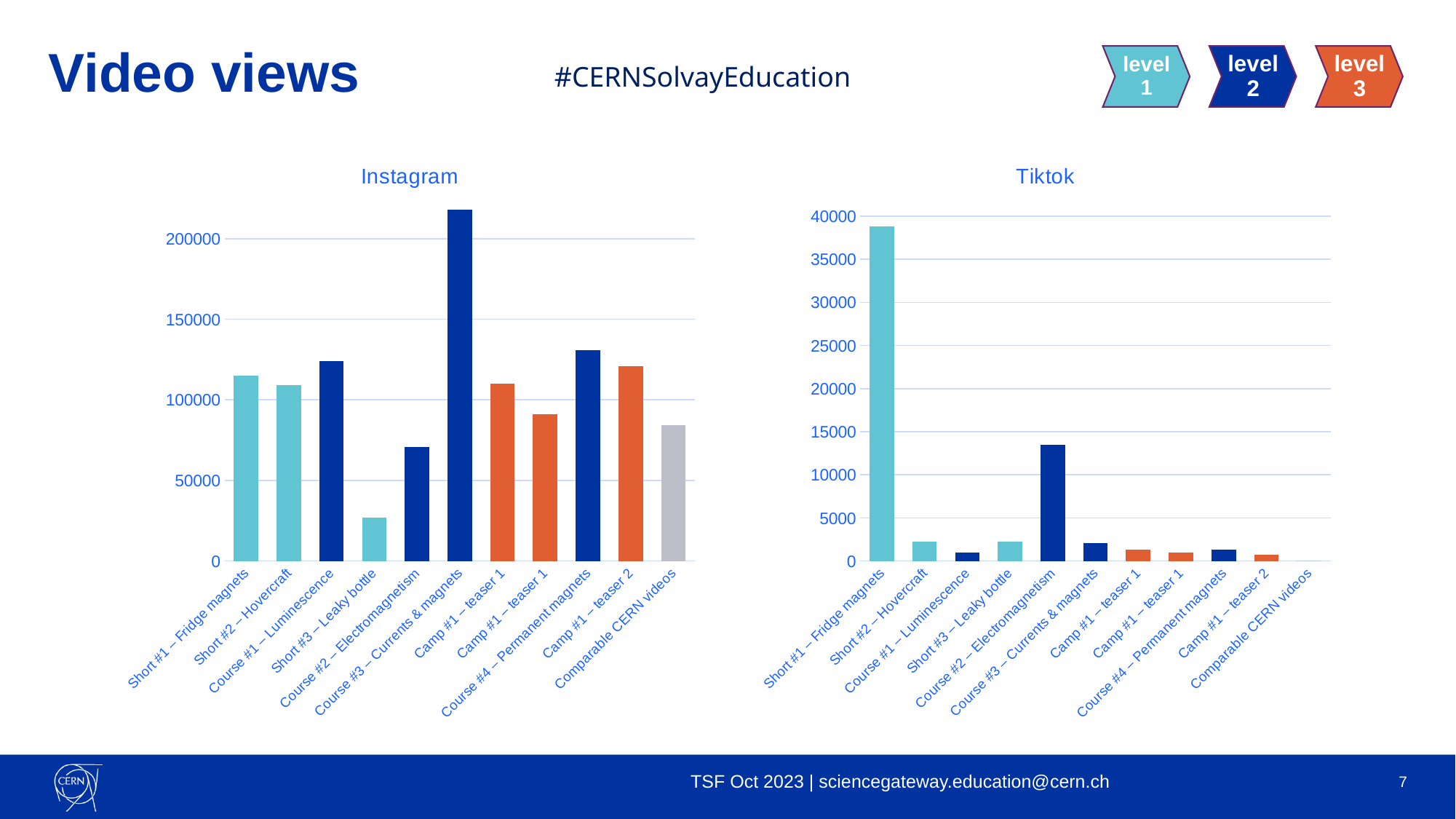
In the Instagram chart, is the value for Course #3 – Currents & magnets greater or less than 200000? greater What kind of chart is the Instagram chart? bar chart What are the titles of the two charts on the slide? Instagram and Tiktok In the Instagram chart, is the value for Short #3 – Leaky bottle greater or less than 50000? less In the Tiktok chart, is the value for Short #1 – Fridge magnets greater or less than 35000? greater In the Instagram chart, which category has the lowest value? Short #3 – Leaky bottle How many categories are shown on the x axis of the Tiktok chart? 11 In the Instagram chart, which category has the highest value? Course #3 – Currents & magnets In the Instagram chart, which is larger: Course #4 – Permanent magnets or Camp #1 – teaser 1? Course #4 – Permanent magnets In the Tiktok chart, which is larger: Short #1 – Fridge magnets or Course #2 – Electromagnetism? Short #1 – Fridge magnets In the Tiktok chart, which category has the highest value? Short #1 – Fridge magnets